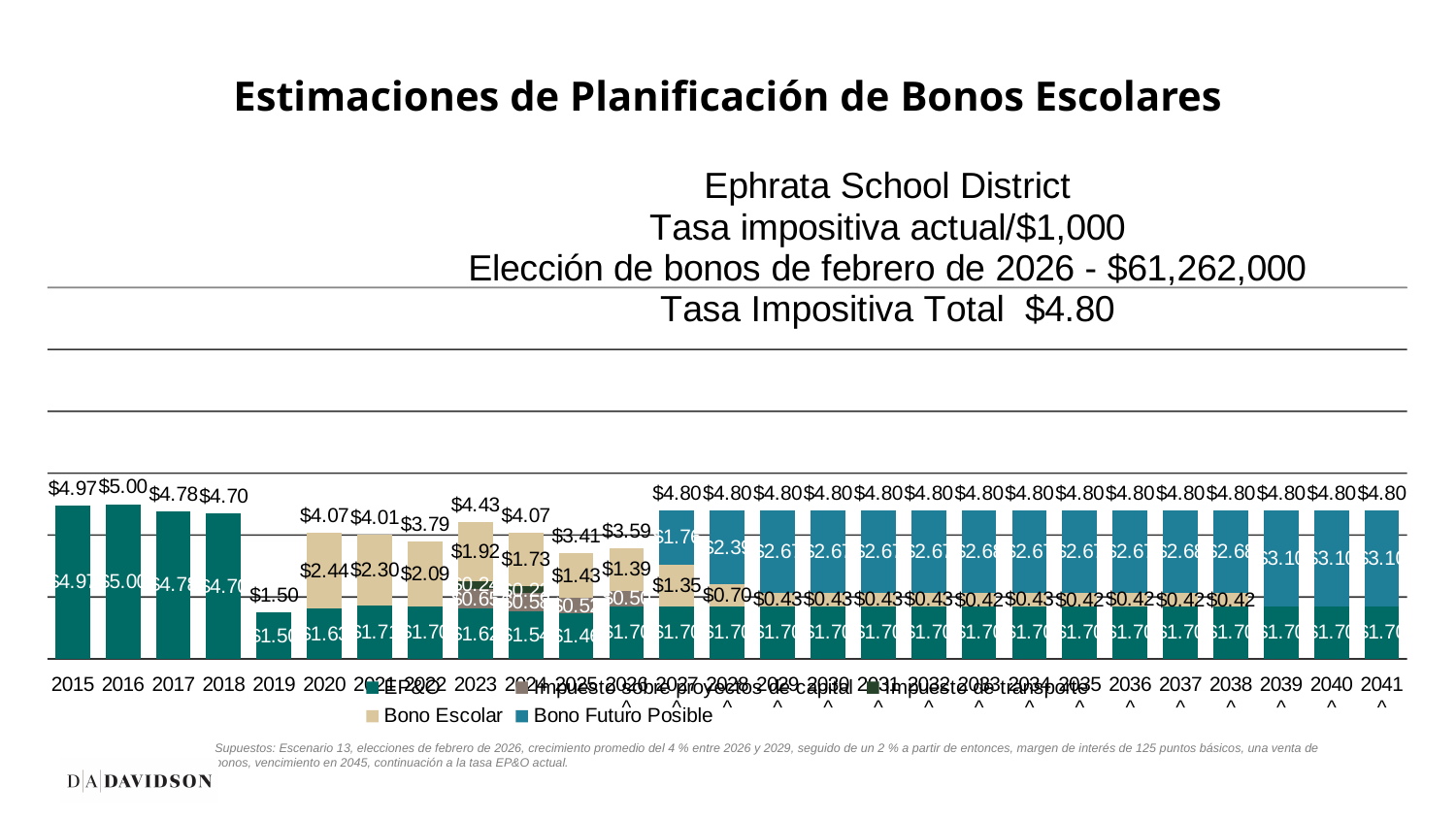
How many years are shown on the x axis? 27 Which year has the lowest total tax rate? 2019 What is the difference between the total tax rate for 2015 and 2016? $0.03 What is the Bono Escolar value for 2020? $2.44 Which year has the highest total tax rate? 2016 How many series does the legend list? 5 What kind of chart is shown on the slide? Stacked bar chart What is the total tax rate shown above the bar for 2041? $4.80 What is the total tax rate shown above the bar for 2019? $1.50 What is the Bono Futuro Posible value for 2041? $3.10 Which is larger, the total tax rate for 2022 or for 2023? 2023 What is the total tax rate shown above the bar for 2016? $5.00